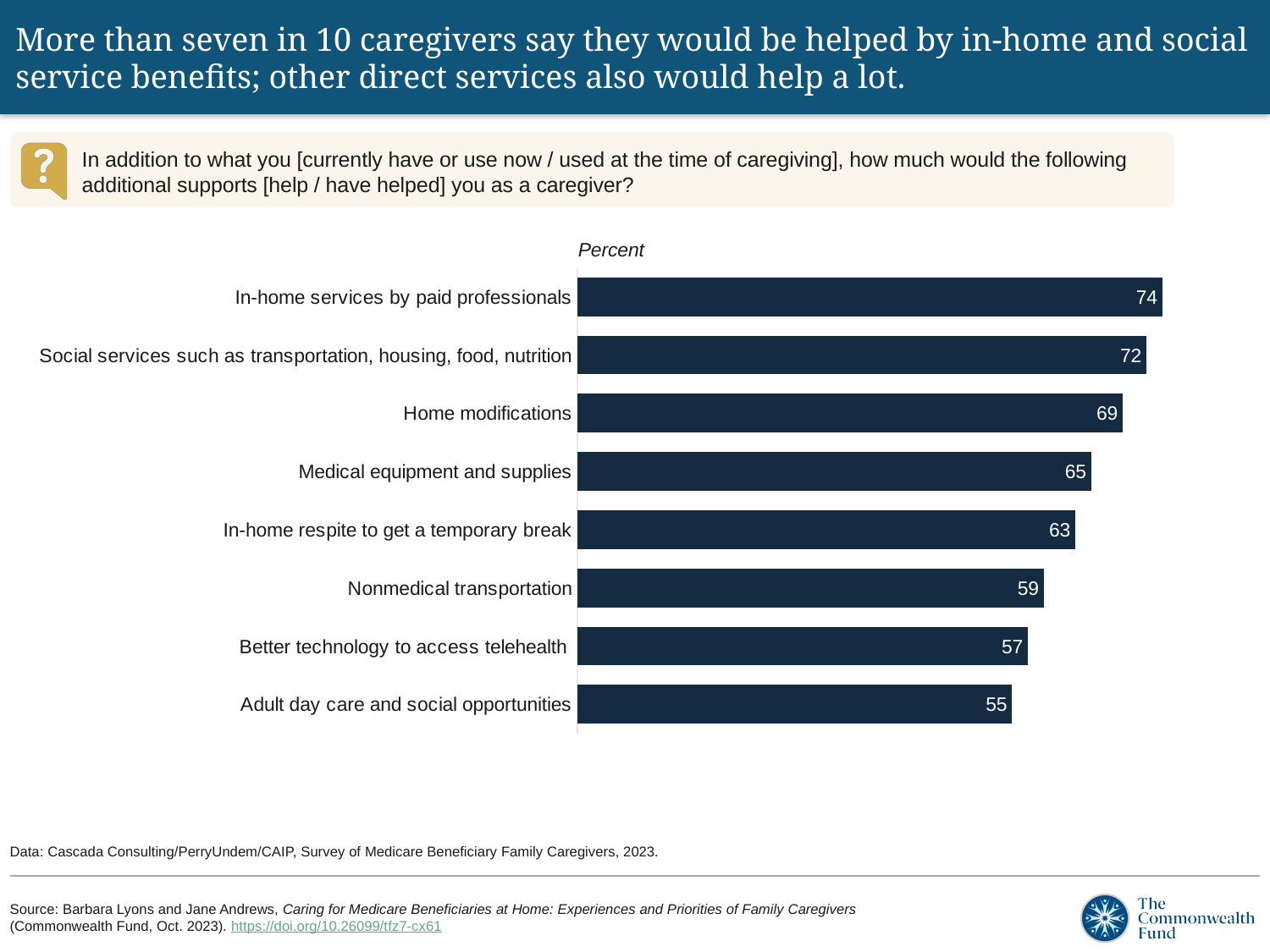
Which category has the lowest value? Adult day care and social opportunities How many categories are shown in the chart? 8 What is the difference between the values for In-home services by paid professionals and Adult day care and social opportunities? 19 What kind of chart is shown on the slide? Bar chart What is the value for Nonmedical transportation? 59 What is the value for Home modifications? 69 What is the value for In-home services by paid professionals? 74 Which category has the highest value? In-home services by paid professionals What is the value for Adult day care and social opportunities? 55 What is the difference between the values for Medical equipment and supplies and In-home respite to get a temporary break? 2 Which is larger: the value for Social services such as transportation, housing, food, nutrition or the value for Better technology to access telehealth? Social services such as transportation, housing, food, nutrition What unit label is shown above the chart? Percent